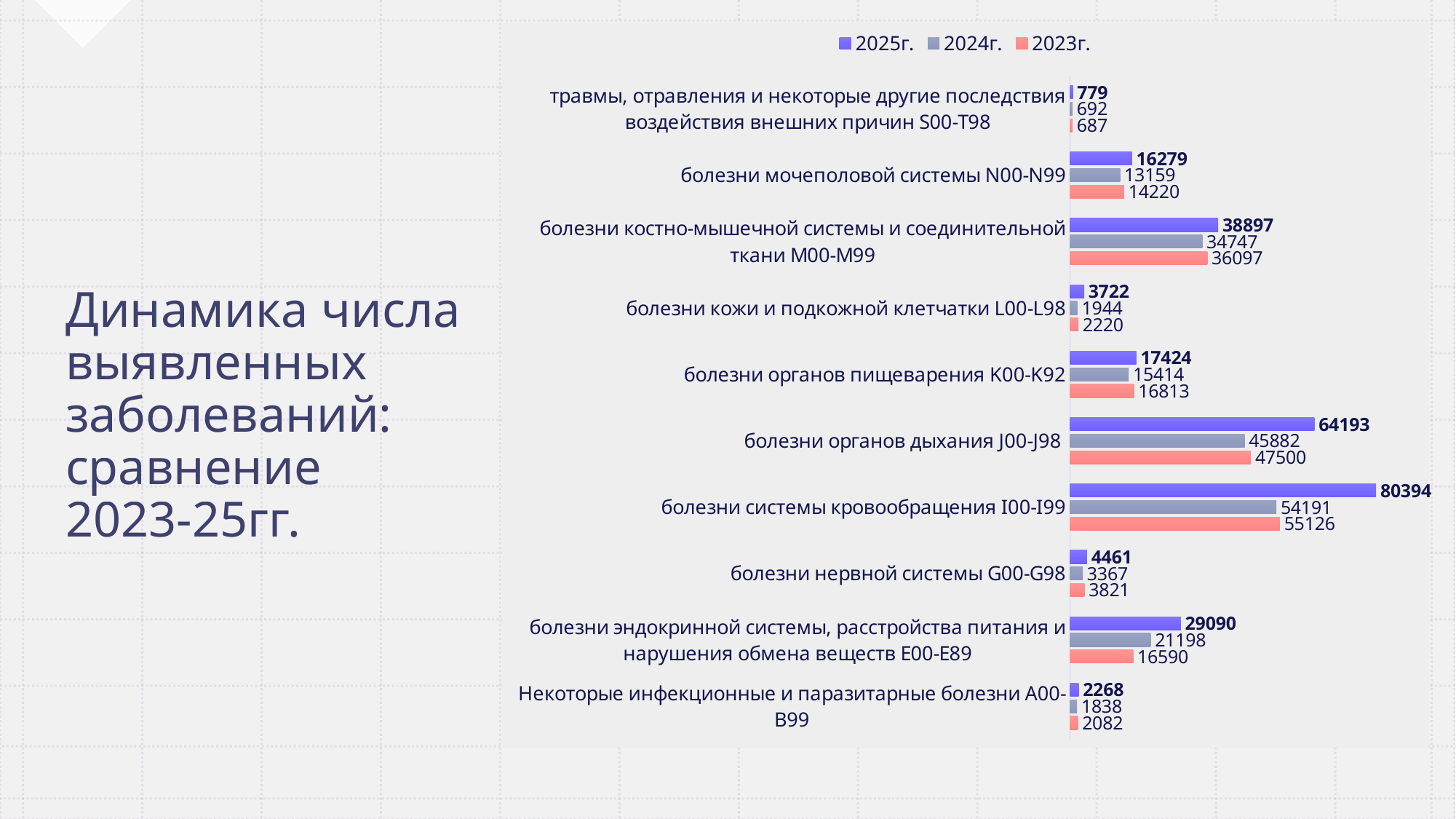
How many disease categories are shown in the chart? 10 What is the 2023г. value for болезни органов дыхания J00-J98? 47500 What is the 2025г. value for болезни системы кровообращения I00-I99? 80394 Which category has the lowest 2023г. value? травмы, отравления и некоторые другие последствия воздействия внешних причин S00-T98 What kind of chart is shown on the slide? bar chart What is the 2024г. value for болезни эндокринной системы, расстройства питания и нарушения обмена веществ E00-E89? 21198 What is the difference between the 2025г. and 2023г. values for болезни эндокринной системы, расстройства питания и нарушения обмена веществ E00-E89? 12500 For болезни кожи и подкожной клетчатки L00-L98, which is larger: the 2025г. value or the 2023г. value? 2025г. Which category has the highest 2025г. value? болезни системы кровообращения I00-I99 How many series does the legend list? 3 What is the difference between the 2025г. and 2024г. values for болезни системы кровообращения I00-I99? 26203 For болезни мочеполовой системы N00-N99, which is larger: the 2024г. value or the 2023г. value? 2023г.